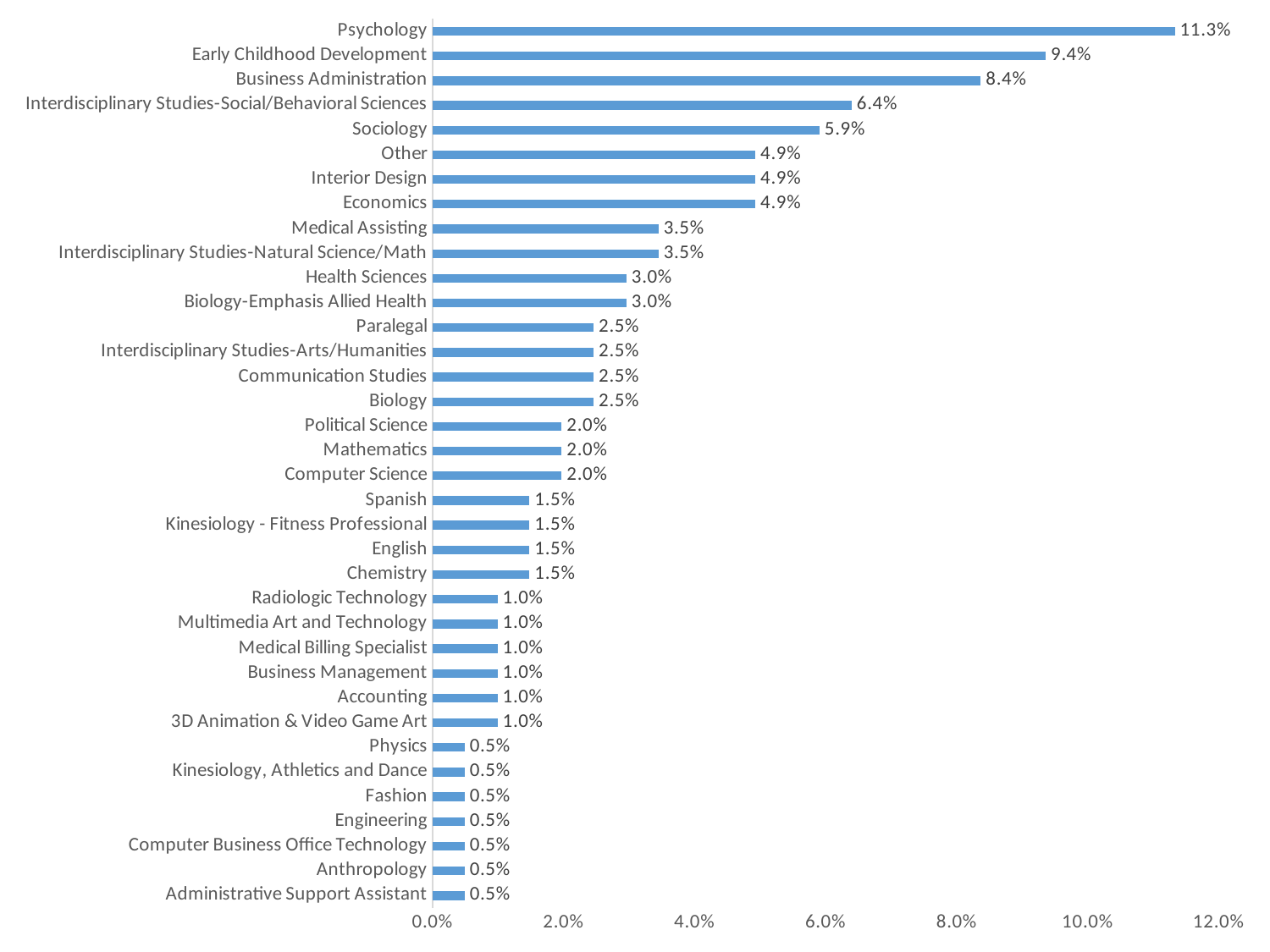
What is the value for Business Administration? 8.4% What is the difference between the values for Psychology and Early Childhood Development? 1.9% Is the value for Early Childhood Development greater or less than 8.0%? greater What is the value for Medical Assisting? 3.5% What is the difference between the values for Business Administration and Sociology? 2.5% What is the value for Computer Science? 2.0% Which category has the highest value? Psychology How many categories are shown in the chart? 36 What is the value for Sociology? 5.9% Which is larger, the value for Interior Design or the value for Health Sciences? Interior Design What is the value for Psychology? 11.3% What kind of chart is shown on the slide? bar chart